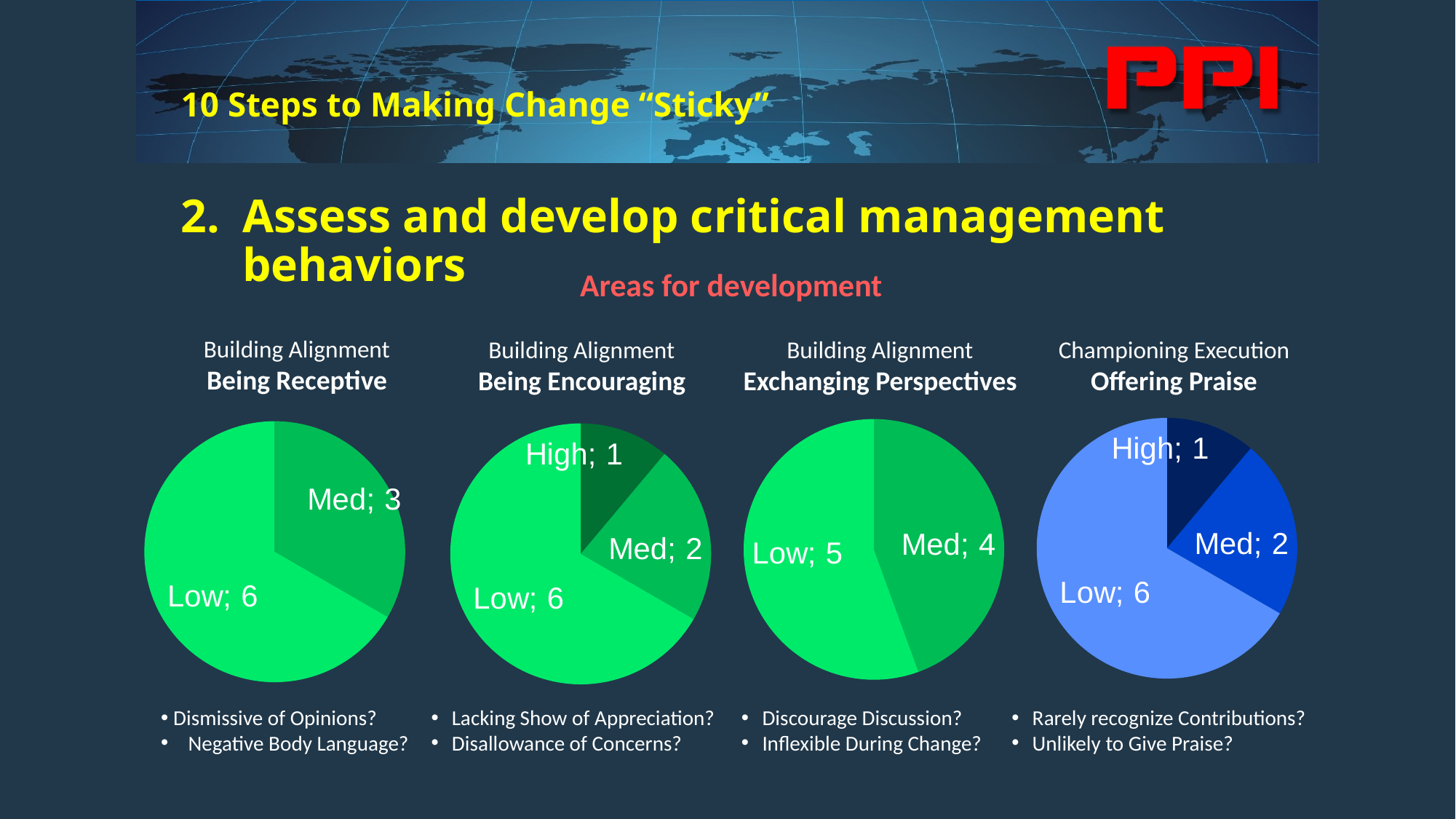
In the "Being Encouraging" pie chart, what is the value for High? 1 In the "Being Encouraging" pie chart, which slice is the largest? Low In the "Exchanging Perspectives" pie chart, what is the value for Med? 4 In the "Exchanging Perspectives" pie chart, what is the difference between the Low and Med values? 1 In the "Being Receptive" pie chart, which is larger, Low or Med? Low In the "Being Receptive" pie chart, what is the value for Med? 3 In the "Being Receptive" pie chart, what is the value for Low? 6 In the "Offering Praise" pie chart, which slice is the smallest? High What type of chart is used for "Offering Praise"? Pie chart How many pie charts are shown on the slide? 4 How many slices does the "Being Encouraging" pie chart have? 3 In the "Offering Praise" pie chart, what is the value for Med? 2